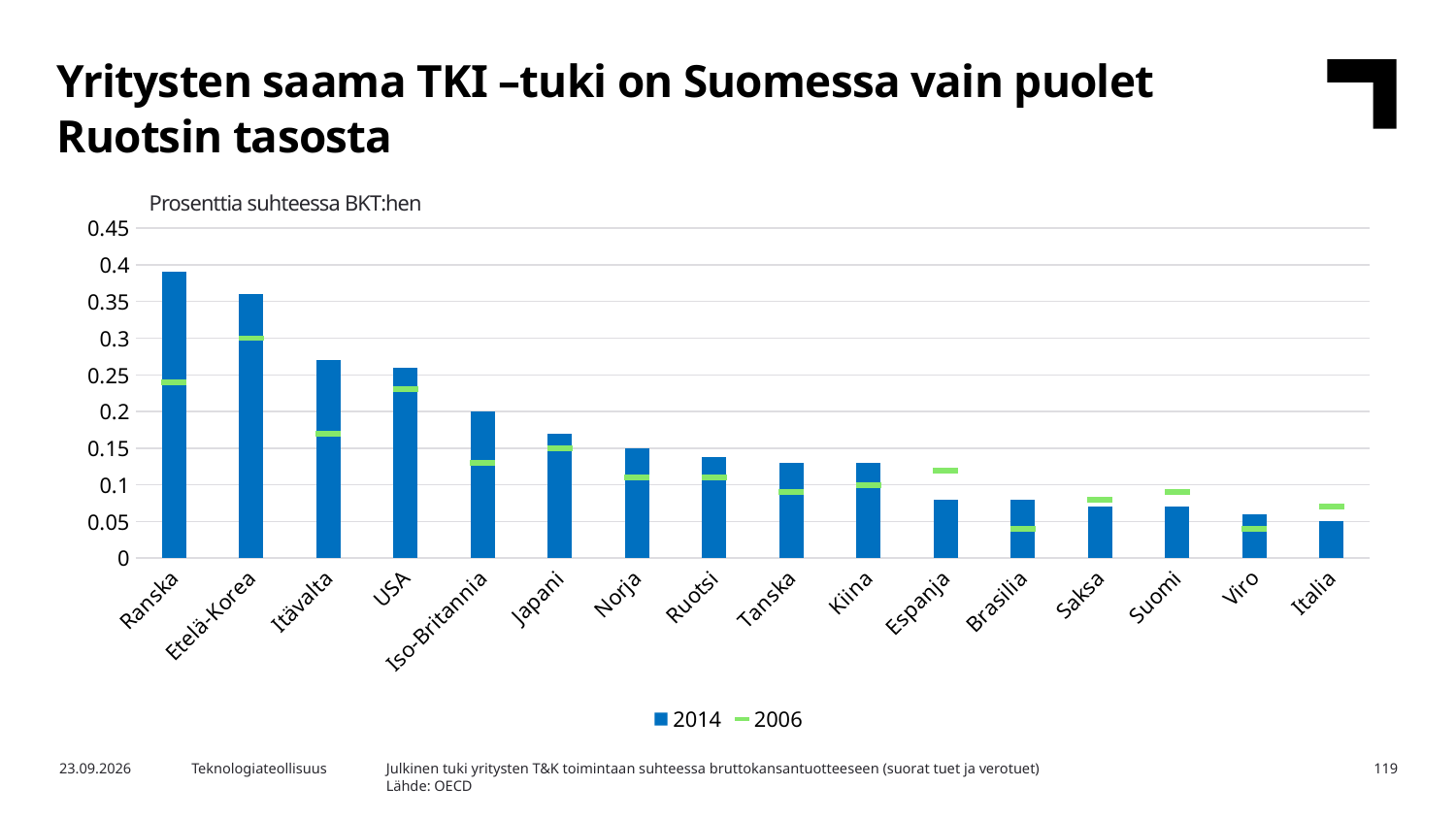
Which country has the highest 2014 value? Ranska Do the 2014 values rise or fall from left to right along the x axis? Fall What kind of chart is shown on the slide? Bar chart Is the 2014 value for Itävalta greater or less than 0.25? greater Which country has the lowest 2014 value? Italia What is the 2014 value for Iso-Britannia? 0.2 How many series does the legend list? 2 How many countries are shown on the x axis? 16 What is the 2014 value for Norja? 0.15 Is the 2014 value for Ranska greater or less than 0.35? greater Is the 2014 value for Suomi greater or less than 0.1? less Which has a larger 2014 value, Ranska or Suomi? Ranska